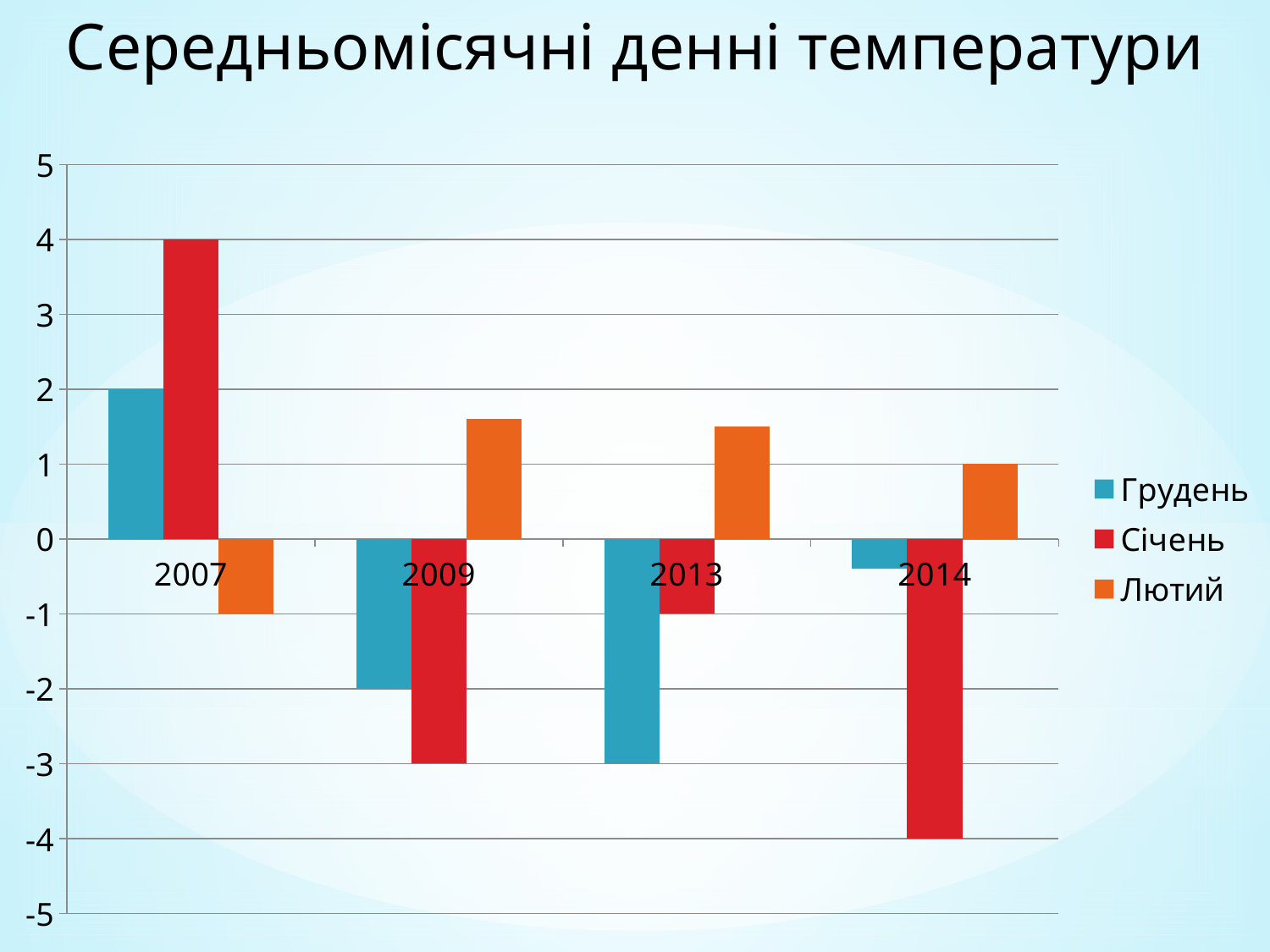
What is the value for Січень in 2007? 4 What is the value for Грудень in 2009? -2 What kind of chart is shown on the slide? bar chart Which is larger, the Грудень value for 2009 or for 2013? 2009 What is the value for Лютий in 2007? -1 What is the difference between the Січень and Грудень values in 2007? 2 Is the value for Лютий in 2009 greater or less than 1? greater How many series does the legend list? 3 In which year is the Січень value lowest? 2014 In which year is the Січень value highest? 2007 How many years are shown on the x axis? 4 What is the value for Січень in 2014? -4